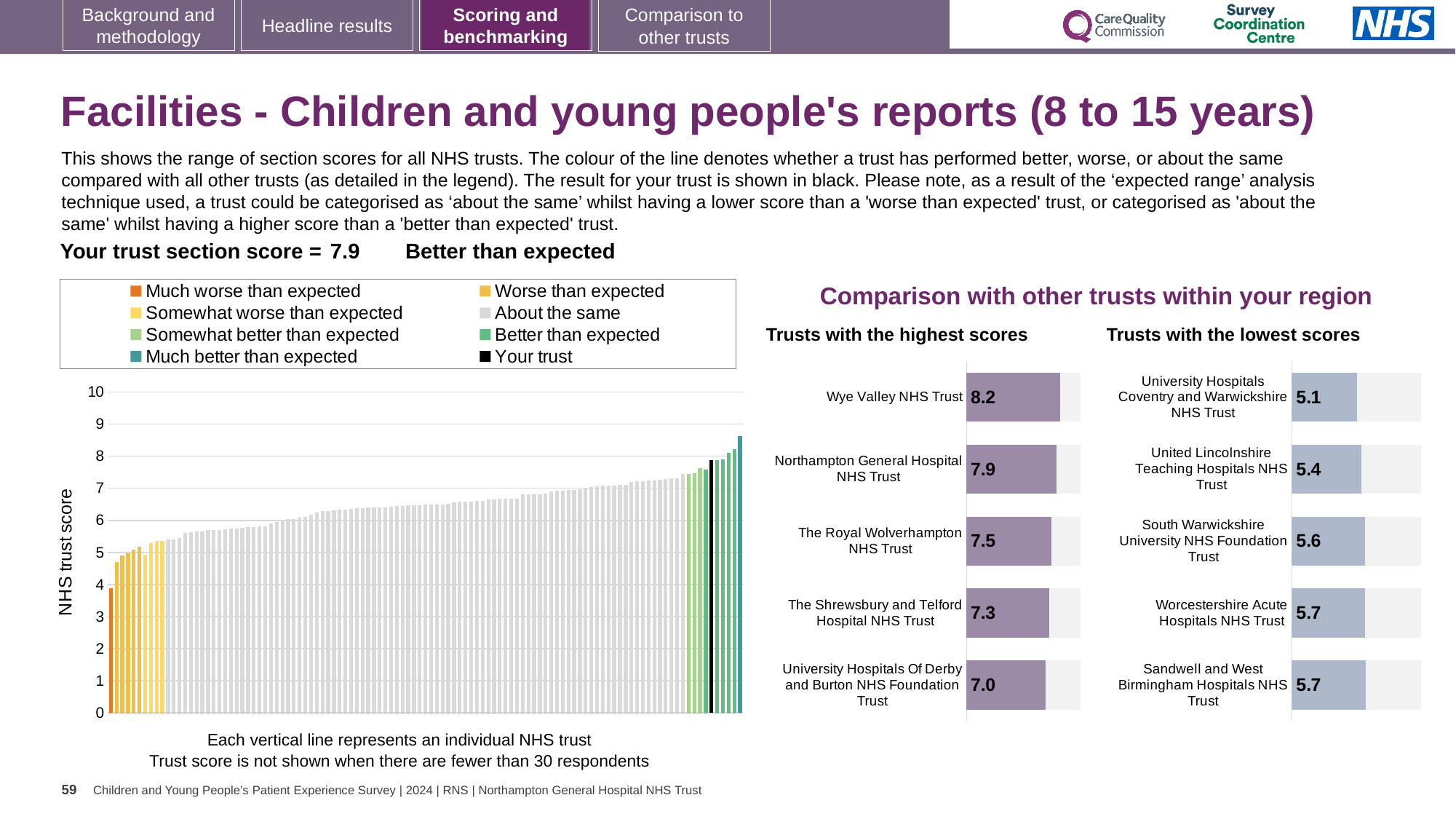
In the 'Trusts with the highest scores' chart, what is the difference between the scores of Wye Valley NHS Trust and Northampton General Hospital NHS Trust? 0.3 In the NHS trust score chart on the left, is the value for the tallest bar greater or less than 8? greater In the 'Trusts with the highest scores' chart, what is the score for Wye Valley NHS Trust? 8.2 In the NHS trust score chart on the left, is the value for the black 'Your trust' bar greater or less than 7? greater In the 'Trusts with the highest scores' chart, what is the score for The Royal Wolverhampton NHS Trust? 7.5 In the 'Trusts with the lowest scores' chart, which has the higher score: South Warwickshire University NHS Foundation Trust or United Lincolnshire Teaching Hospitals NHS Trust? South Warwickshire University NHS Foundation Trust How many entries does the legend of the NHS trust score chart on the left list? 8 In the 'Trusts with the lowest scores' chart, which trust has the lowest score? University Hospitals Coventry and Warwickshire NHS Trust In the 'Trusts with the lowest scores' chart, what is the score for United Lincolnshire Teaching Hospitals NHS Trust? 5.4 In the 'Trusts with the highest scores' chart, which trust has the lowest score? University Hospitals Of Derby and Burton NHS Foundation Trust What type of chart is the 'Trusts with the highest scores' chart? Bar chart How many trusts are shown in the 'Trusts with the lowest scores' chart? 5